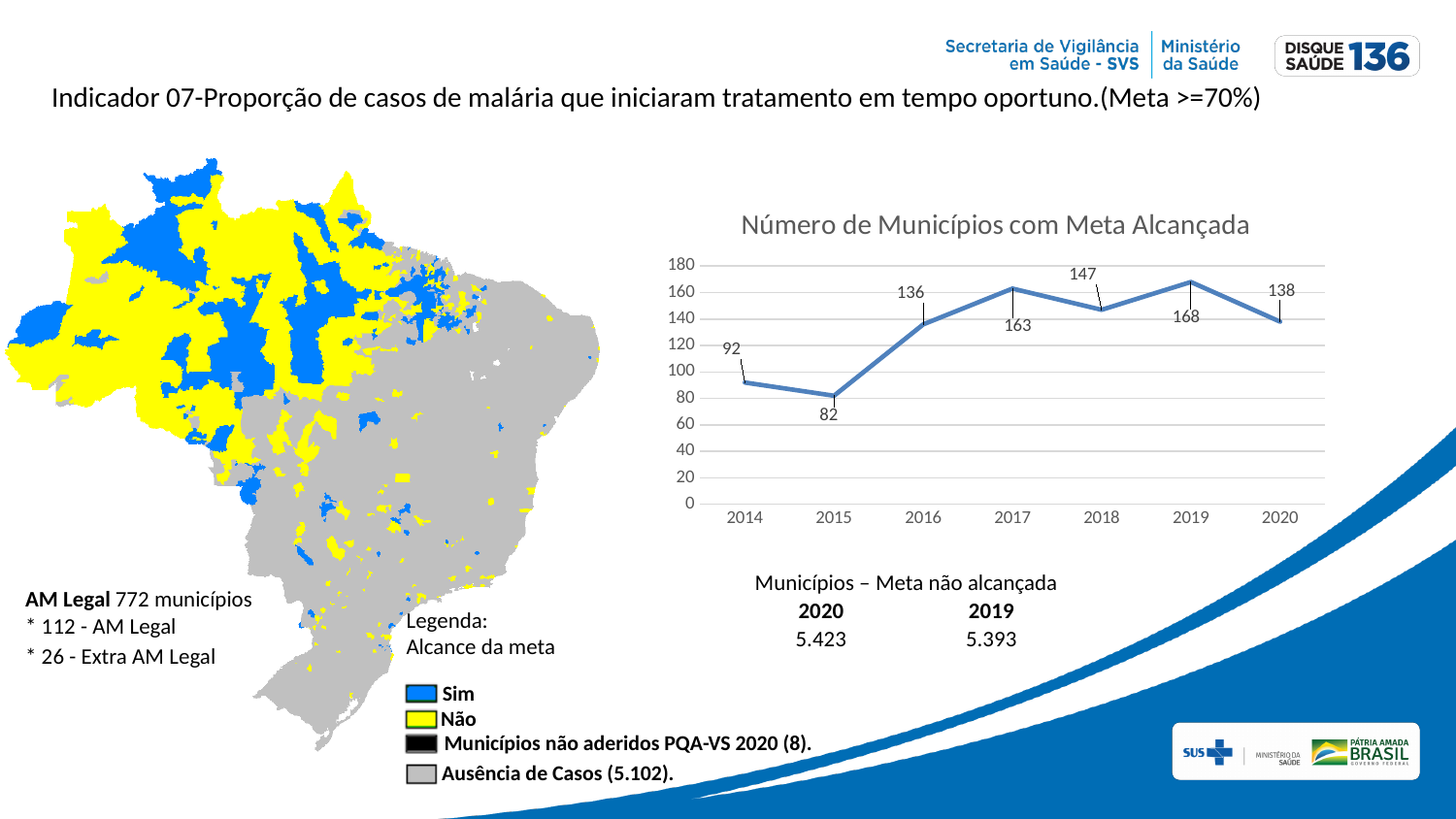
In the chart 'Número de Municípios com Meta Alcançada', what is the value for 2014? 92 How many years are plotted in the chart 'Número de Municípios com Meta Alcançada'? 7 What is the title of the line chart on the slide? Número de Municípios com Meta Alcançada In the chart 'Número de Municípios com Meta Alcançada', what is the difference between the values for 2019 and 2020? 30 In the chart 'Número de Municípios com Meta Alcançada', which year has the highest value? 2019 In the chart 'Número de Municípios com Meta Alcançada', what is the value for 2017? 163 In the chart 'Número de Municípios com Meta Alcançada', which year has the lowest value? 2015 In the chart 'Número de Municípios com Meta Alcançada', what is the value for 2020? 138 In the chart 'Número de Municípios com Meta Alcançada', what is the difference between the values for 2017 and 2016? 27 What type of chart is 'Número de Municípios com Meta Alcançada'? line chart In the chart 'Número de Municípios com Meta Alcançada', does the value rise or fall from 2014 to 2015? fall In the chart 'Número de Municípios com Meta Alcançada', which is larger, the value for 2018 or the value for 2016? 2018